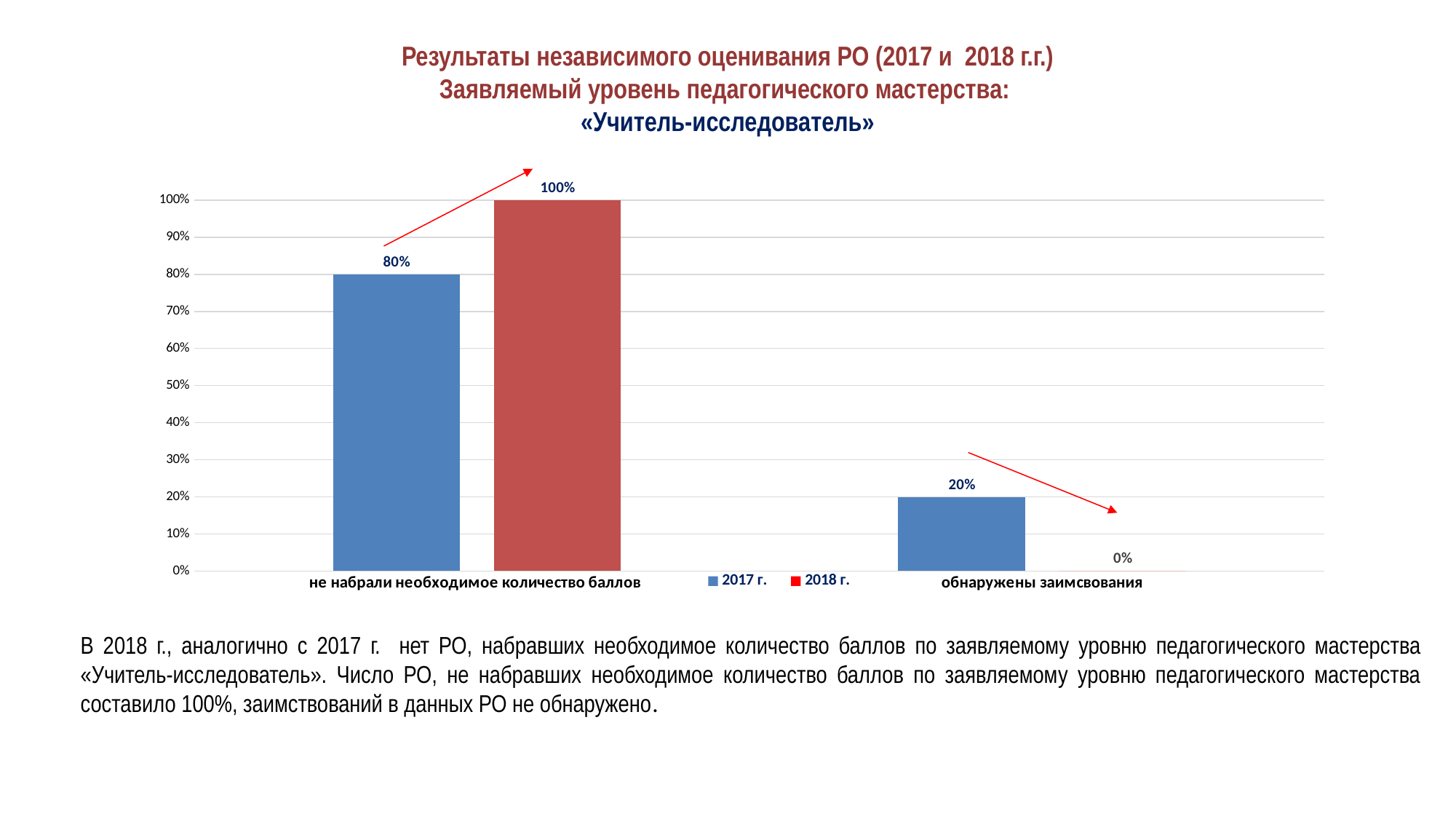
Which is larger for «обнаружены заимсвования»: the 2017 г. value or the 2018 г. value? 2017 г. What is the value for 2018 г. in the category «не набрали необходимое количество баллов»? 100% How many series does the legend list? 2 What kind of chart is shown on the slide? bar chart What is the difference between the 2018 г. and 2017 г. values for «не набрали необходимое количество баллов»? 20% Which category has the highest value for the 2018 г. series? не набрали необходимое количество баллов Which colour represents the 2018 г. series in the chart? red What is the value for 2017 г. in the category «обнаружены заимсвования»? 20% Which category has the lowest value for the 2017 г. series? обнаружены заимсвования What is the value for 2018 г. in the category «обнаружены заимсвования»? 0% How many categories are shown on the x axis? 2 What is the value for 2017 г. in the category «не набрали необходимое количество баллов»? 80%